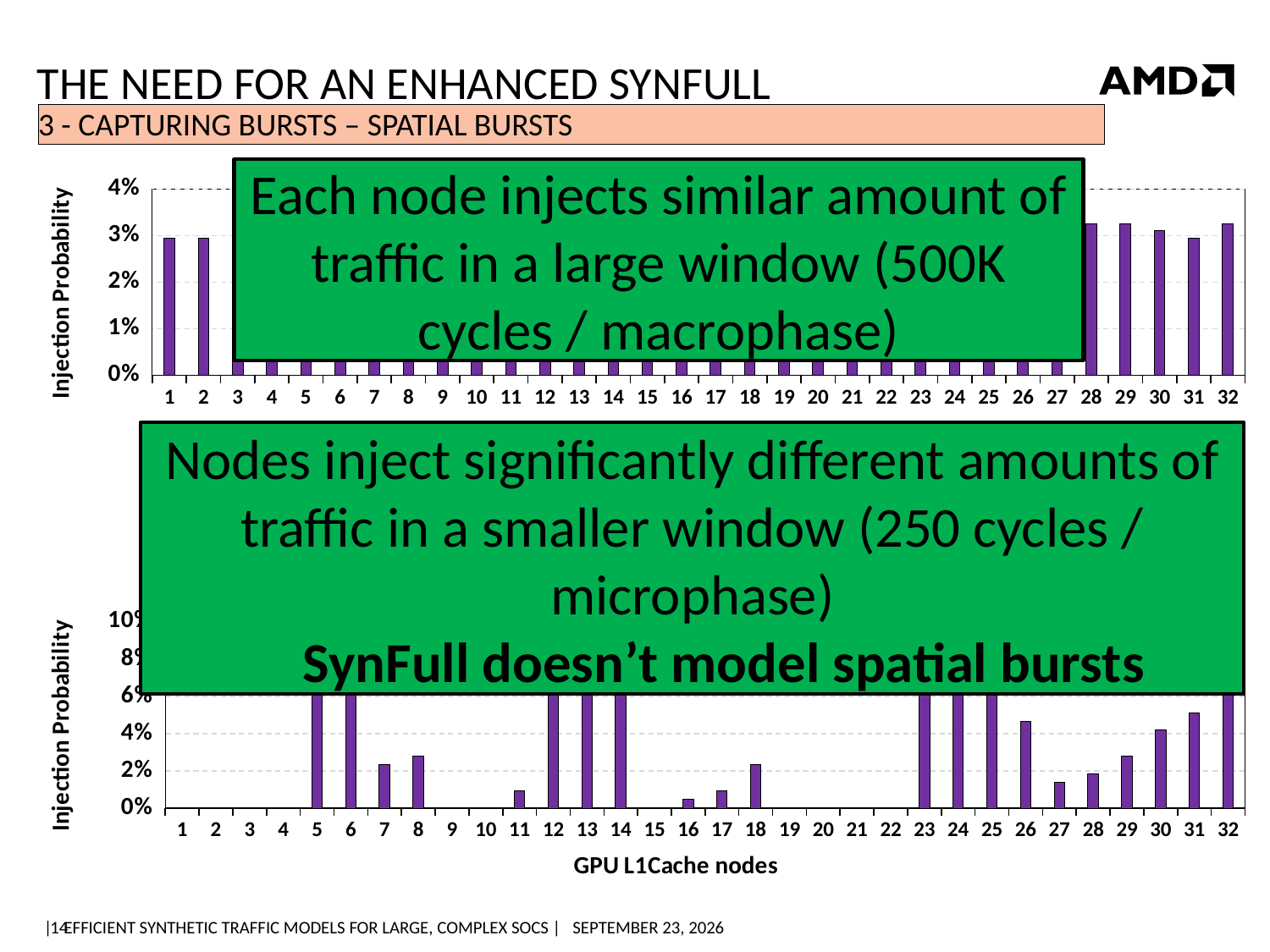
What kind of chart is the top chart on the slide? bar chart In the bottom chart, is the value for node 26 greater or less than 4%? greater In the bottom chart, is the value for node 27 greater or less than 2%? less In the bottom chart, which has the larger value, node 30 or node 7? node 30 In the bottom chart, which has the larger value, node 31 or node 26? node 31 In the bottom chart, is the value for node 8 greater or less than 2%? greater What is the x-axis title of the bottom chart? GPU L1Cache nodes What is the y-axis label of the top chart? Injection Probability How many nodes are shown along the x axis of the bottom chart? 32